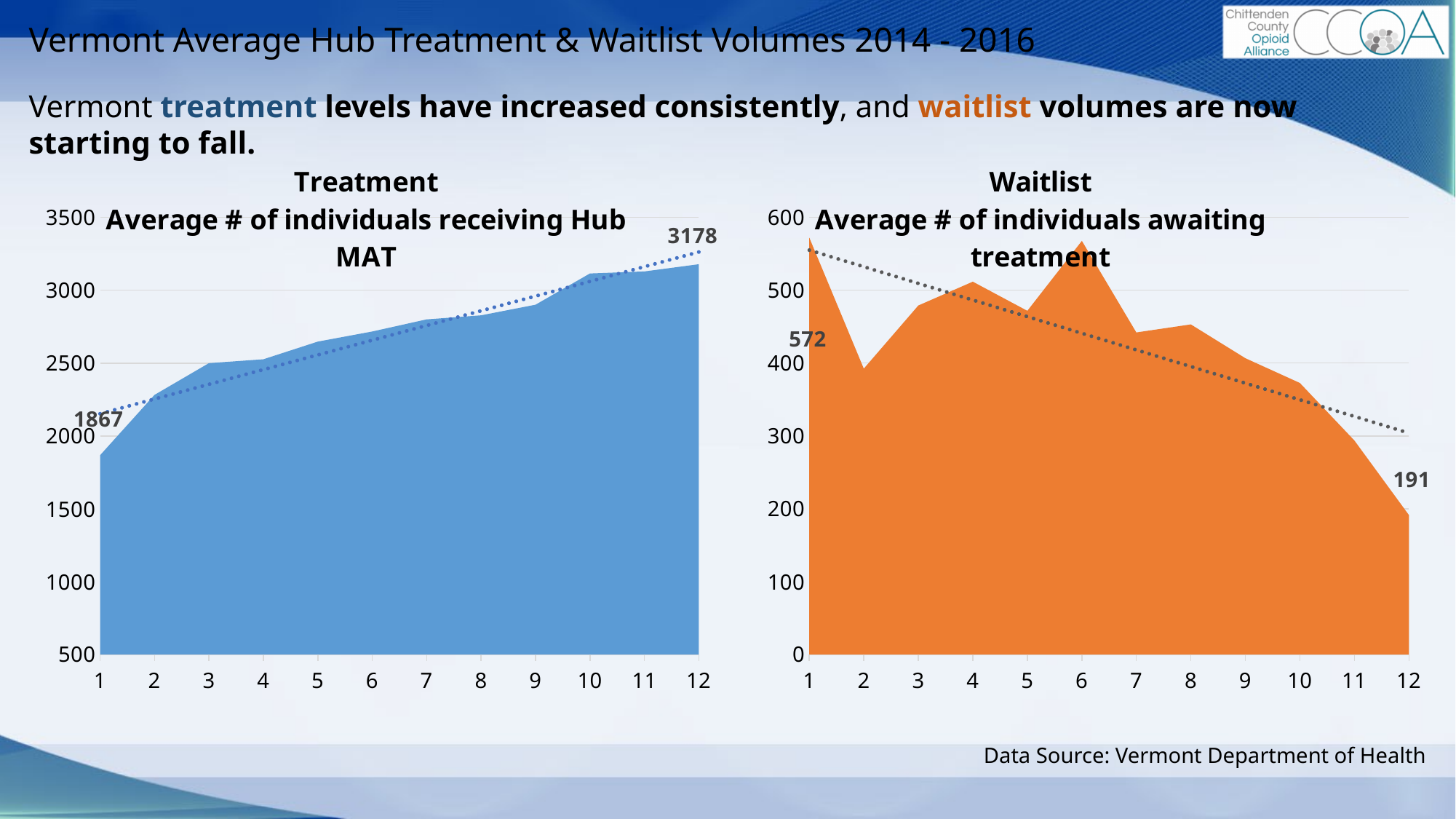
In the Treatment chart, do the values generally rise or fall from point 1 to point 12? rise In the Treatment chart, what is the difference between the values at point 12 and point 1? 1311 In the Waitlist chart, what is the value at point 1? 572 How many points are plotted along the x axis of the Waitlist chart? 12 In the Waitlist chart, is the value at point 12 greater or less than 200? less In the Treatment chart, what is the value at point 12? 3178 In the Waitlist chart, what is the value at point 12? 191 In the Treatment chart, is the value at point 6 greater or less than 2500? greater In the Treatment chart, what is the value at point 1? 1867 What kind of chart is the Treatment chart? area chart In the Waitlist chart, what is the difference between the values at point 1 and point 12? 381 In the Waitlist chart, is the value at point 6 greater or less than 500? greater